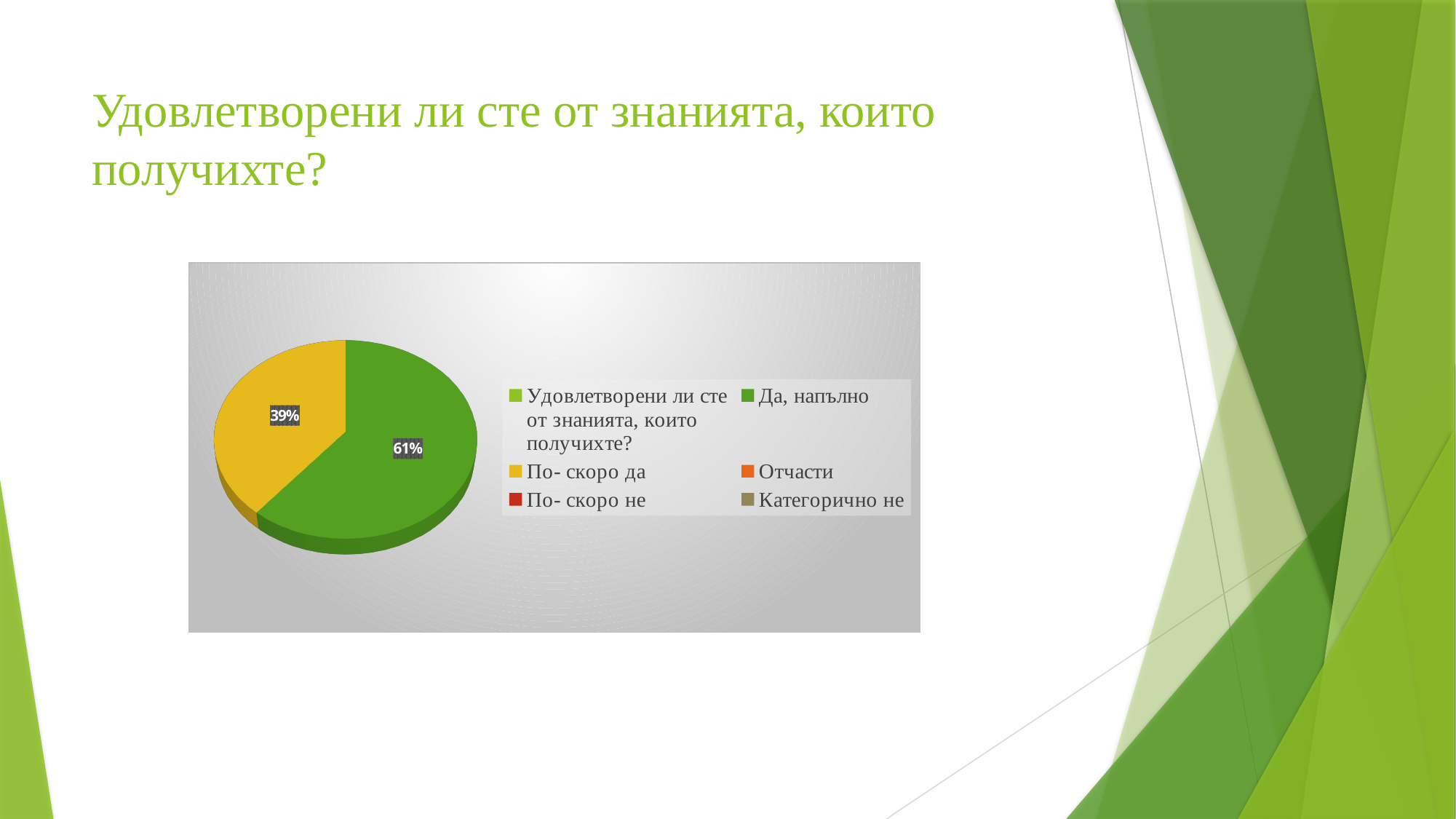
How many entries does the legend list? 6 Which category has the largest slice of the pie? Да, напълно How many slices are visible in the pie? 2 Which is larger: the "Да, напълно" slice or the "По- скоро да" slice? Да, напълно What kind of chart is shown on the slide? Pie chart What colour is the "Да, напълно" slice? Green Which of the two visible slices is the smaller one? По- скоро да What is the difference in percentage points between the "Да, напълно" slice and the "По- скоро да" slice? 22 What percentage of the pie is labelled for "По- скоро да"? 39% What percentage of the pie is labelled for "Да, напълно"? 61% What colour is the "По- скоро да" slice? Yellow What share of the pie does the "Да, напълно" slice take? 61%